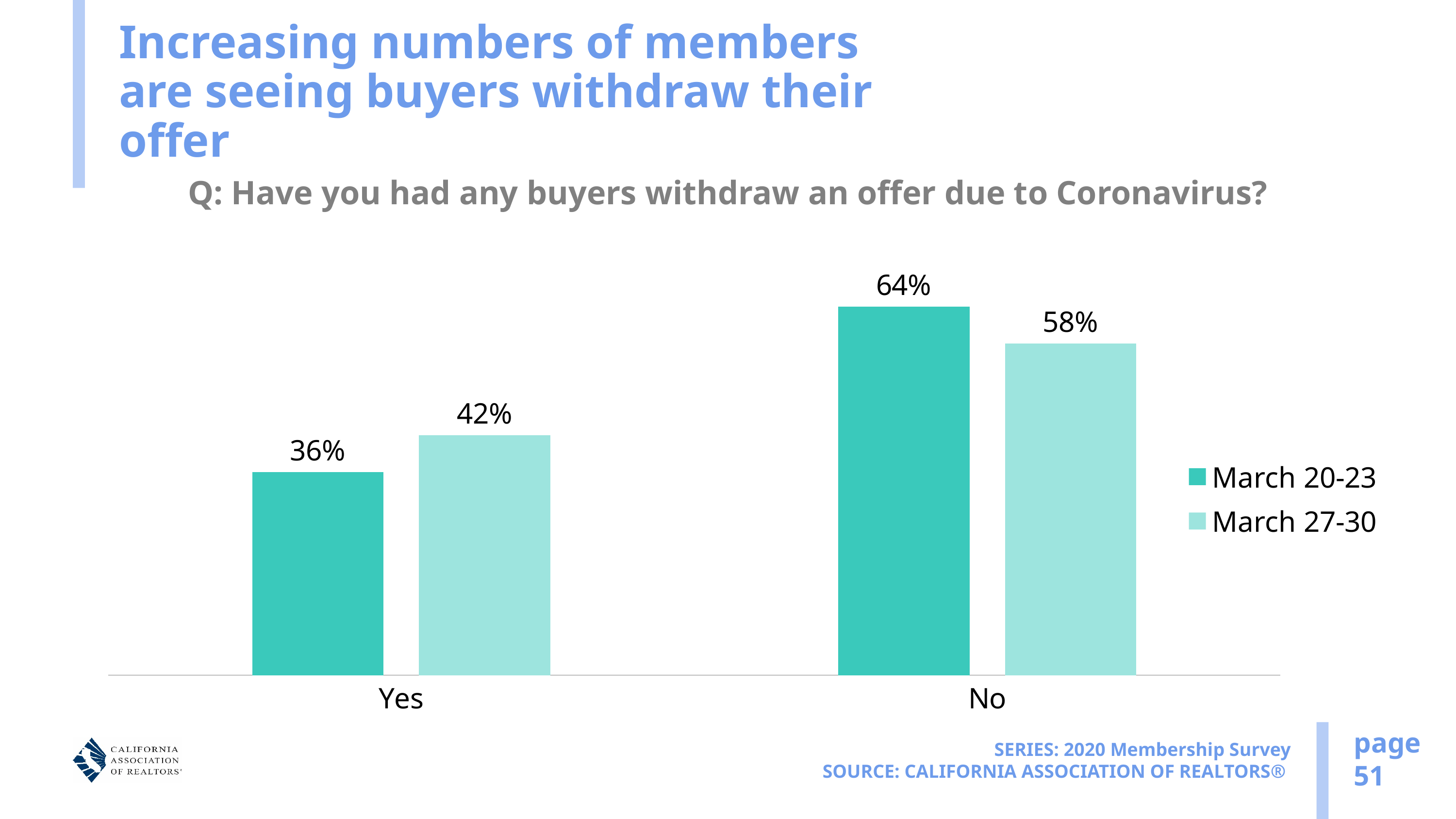
How many series does the legend list? 2 What is the difference between the No values for March 20-23 and March 27-30? 6 percentage points Which response category has the highest value in the March 20-23 series? No Which response category has the lowest value in the March 27-30 series? Yes What percentage of members answered Yes in the March 27-30 survey? 42% Which is larger: the Yes value for March 27-30 or the Yes value for March 20-23? March 27-30 How many response categories are shown on the x axis? 2 By how many percentage points did the Yes response increase from March 20-23 to March 27-30? 6 percentage points What percentage of members answered No in the March 20-23 survey? 64% What percentage of members answered Yes in the March 20-23 survey? 36% What percentage of members answered No in the March 27-30 survey? 58% What kind of chart is shown on the slide? Bar chart